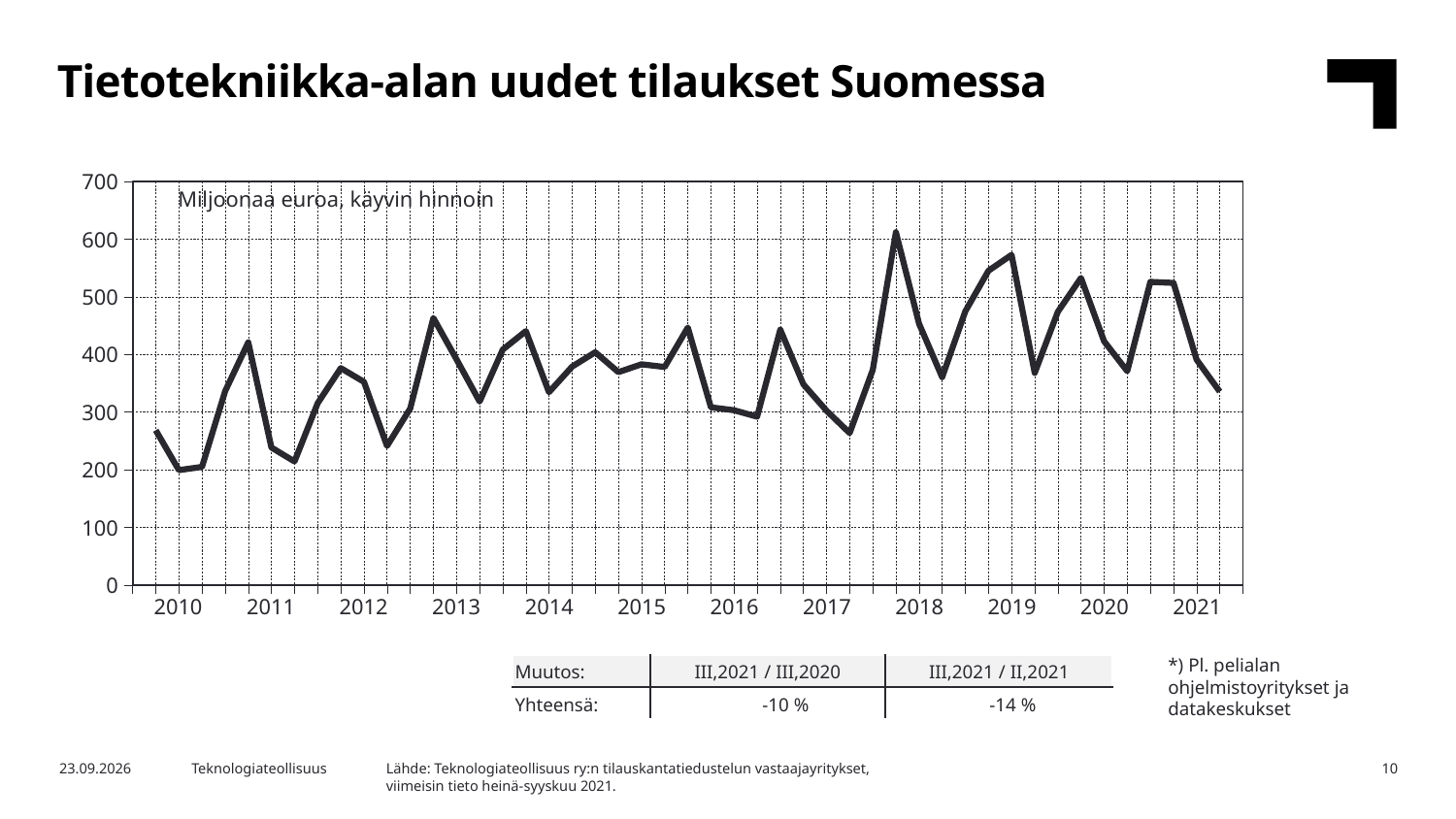
Is the highest point of the line in 2018 greater or less than 500? greater Is the lowest point of the line in 2012 greater or less than 300? less What unit label is printed inside the chart area? Miljoonaa euroa, käyvin hinnoin What kind of chart is shown on the slide? line chart Is the lowest point of the line in 2017 greater or less than 300? less How many years are labelled on the x axis of the chart? 12 In which year does the line reach its highest point? 2018 How many lines are plotted in the chart? 1 What is the title of the slide's chart? Tietotekniikka-alan uudet tilaukset Suomessa